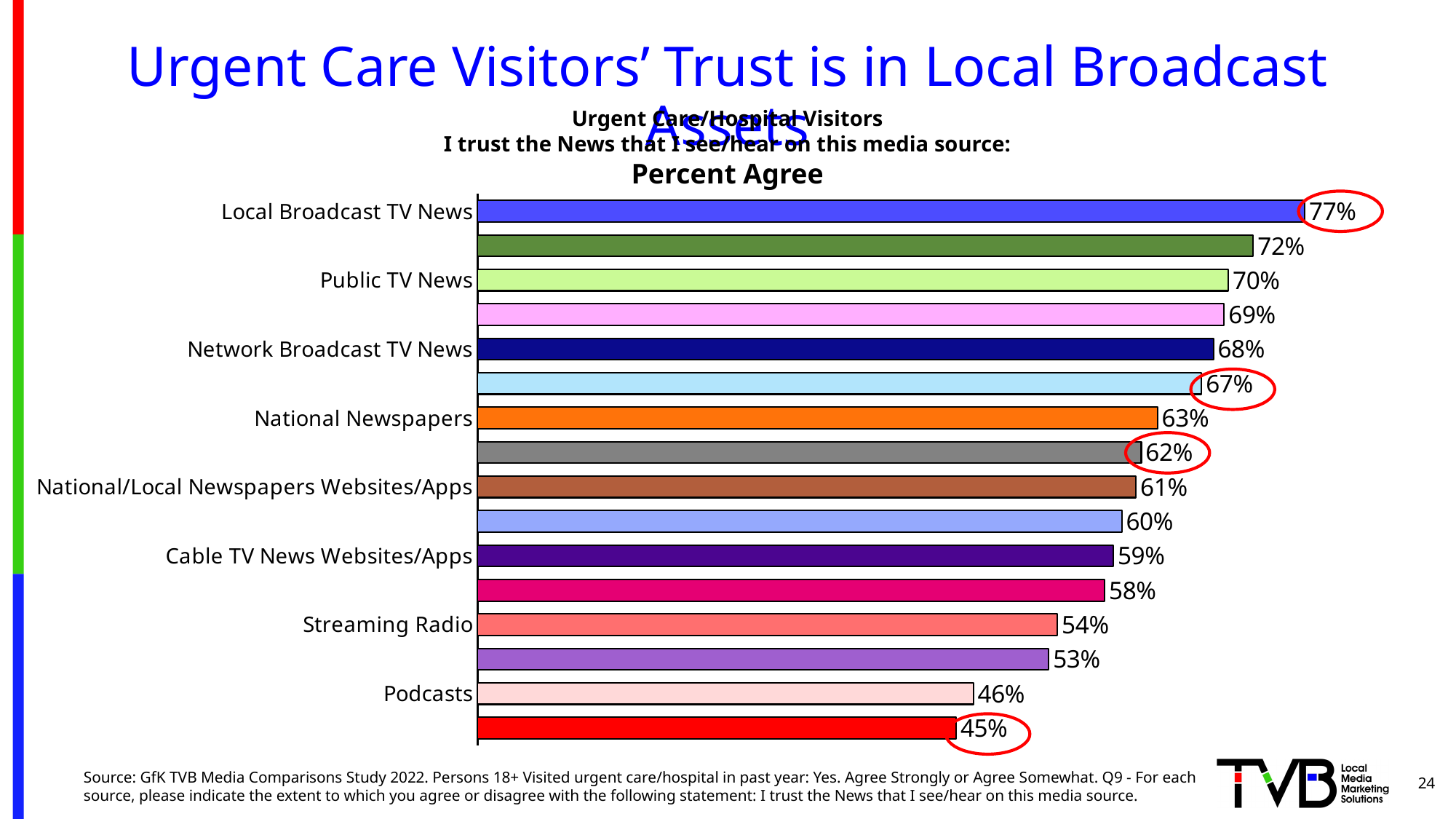
What is the lowest Percent Agree value shown on the chart? 45% What is the difference in Percent Agree between Local Broadcast TV News and Network Broadcast TV News? 9 percentage points How many bars are plotted on the chart? 16 Which media source has the highest Percent Agree on the chart? Local Broadcast TV News Which value on the chart is circled at the top of the chart? 77% What percent of urgent care/hospital visitors agree they trust the news on Local Broadcast TV News? 77% What type of chart is shown on the slide? Bar chart What is the Percent Agree value for Podcasts? 46% What is the Percent Agree value for Public TV News? 70% Which has a higher Percent Agree, National Newspapers or Cable TV News Websites/Apps? National Newspapers What is the Percent Agree value for Network Broadcast TV News? 68% What is the Percent Agree value for Streaming Radio? 54%